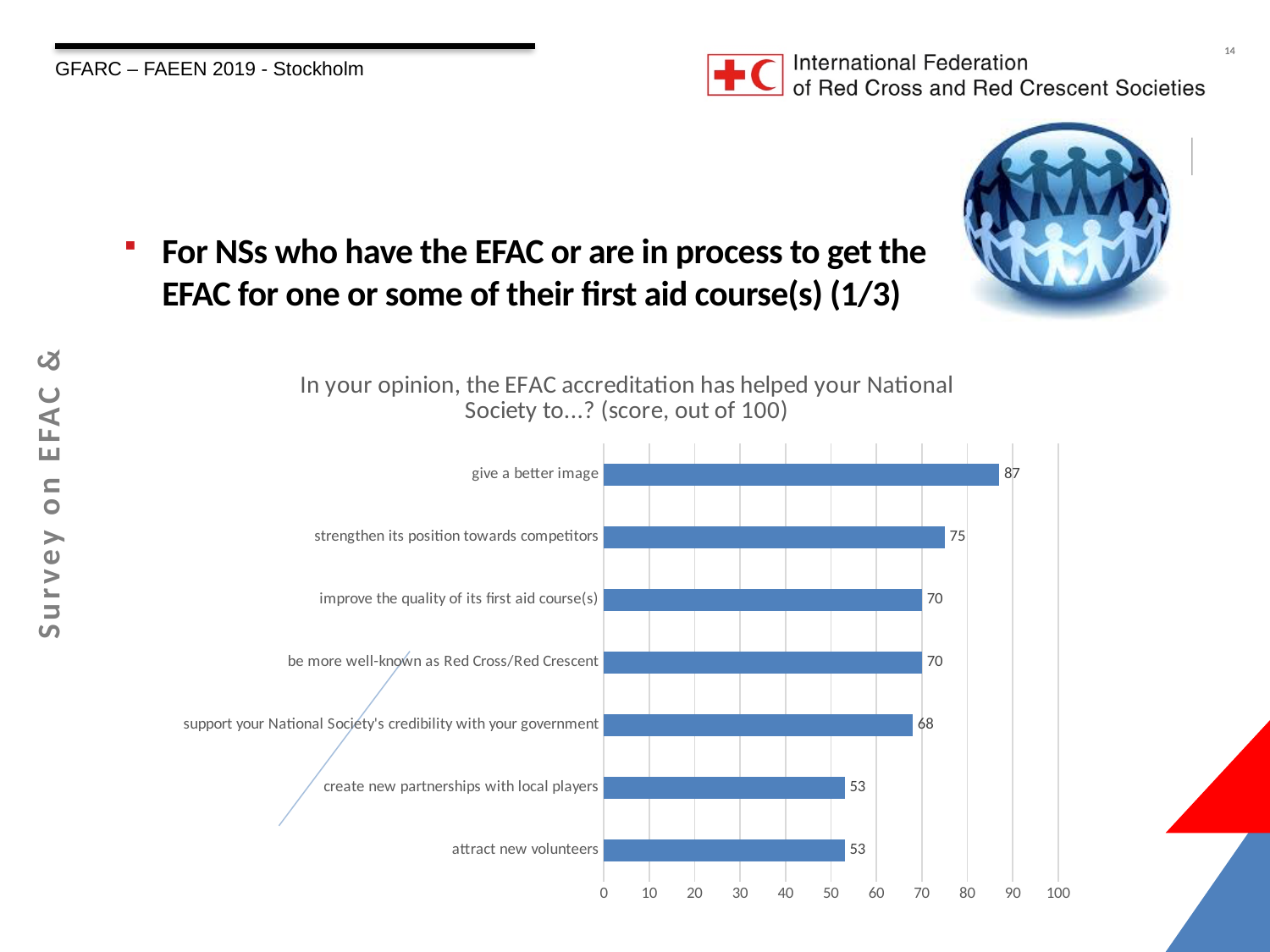
Is the score for "create new partnerships with local players" greater or less than 60? less What score is shown for "strengthen its position towards competitors"? 75 What is the difference between the scores for "give a better image" and "strengthen its position towards competitors"? 12 Which category has the highest score? give a better image What score is shown for "support your National Society's credibility with your government"? 68 What is the title of the chart? In your opinion, the EFAC accreditation has helped your National Society to…? (score, out of 100) What is the difference between the scores for "improve the quality of its first aid course(s)" and "create new partnerships with local players"? 17 Which has a higher score: "strengthen its position towards competitors" or "support your National Society's credibility with your government"? strengthen its position towards competitors What type of chart is shown on the slide? bar chart How many categories are shown in the chart? 7 What score is shown for "attract new volunteers"? 53 What score is shown for "give a better image"? 87